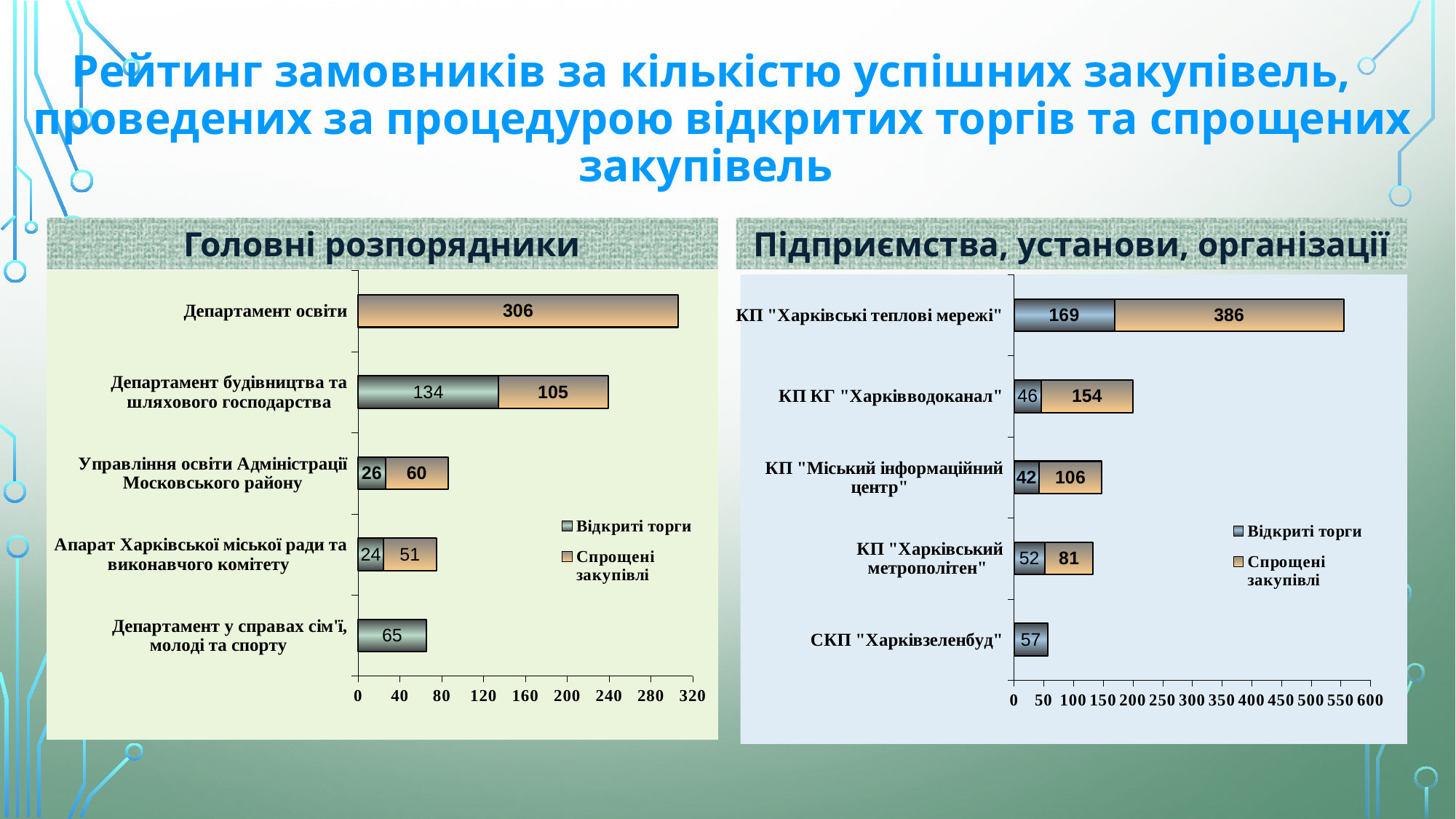
In the chart "Головні розпорядники", what is the value of Відкриті торги for Департамент у справах сім'ї, молоді та спорту? 65 In the chart "Підприємства, установи, організації", how many series does the legend list? 2 In the chart "Підприємства, установи, організації", which is larger: Відкриті торги for КП "Харківський метрополітен" or Відкриті торги for КП КГ "Харківводоканал"? КП "Харківський метрополітен" In the chart "Підприємства, установи, організації", what is the value of Спрощені закупівлі for КП "Харківські теплові мережі"? 386 In the chart "Головні розпорядники", what is the total of the stacked bar for Департамент будівництва та шляхового господарства? 239 In the chart "Головні розпорядники", what is the value of Спрощені закупівлі for Департамент освіти? 306 What type of chart is shown under "Підприємства, установи, організації"? Stacked bar chart In the chart "Головні розпорядники", what is the value of Відкриті торги for Департамент будівництва та шляхового господарства? 134 In the chart "Головні розпорядники", how many categories are shown? 5 In the chart "Головні розпорядники", what is the difference between Спрощені закупівлі and Відкриті торги for Управління освіти Адміністрації Московського району? 34 In the chart "Підприємства, установи, організації", which category has the longest total bar? КП "Харківські теплові мережі" In the chart "Підприємства, установи, організації", what is the total of the stacked bar for КП "Харківські теплові мережі"? 555